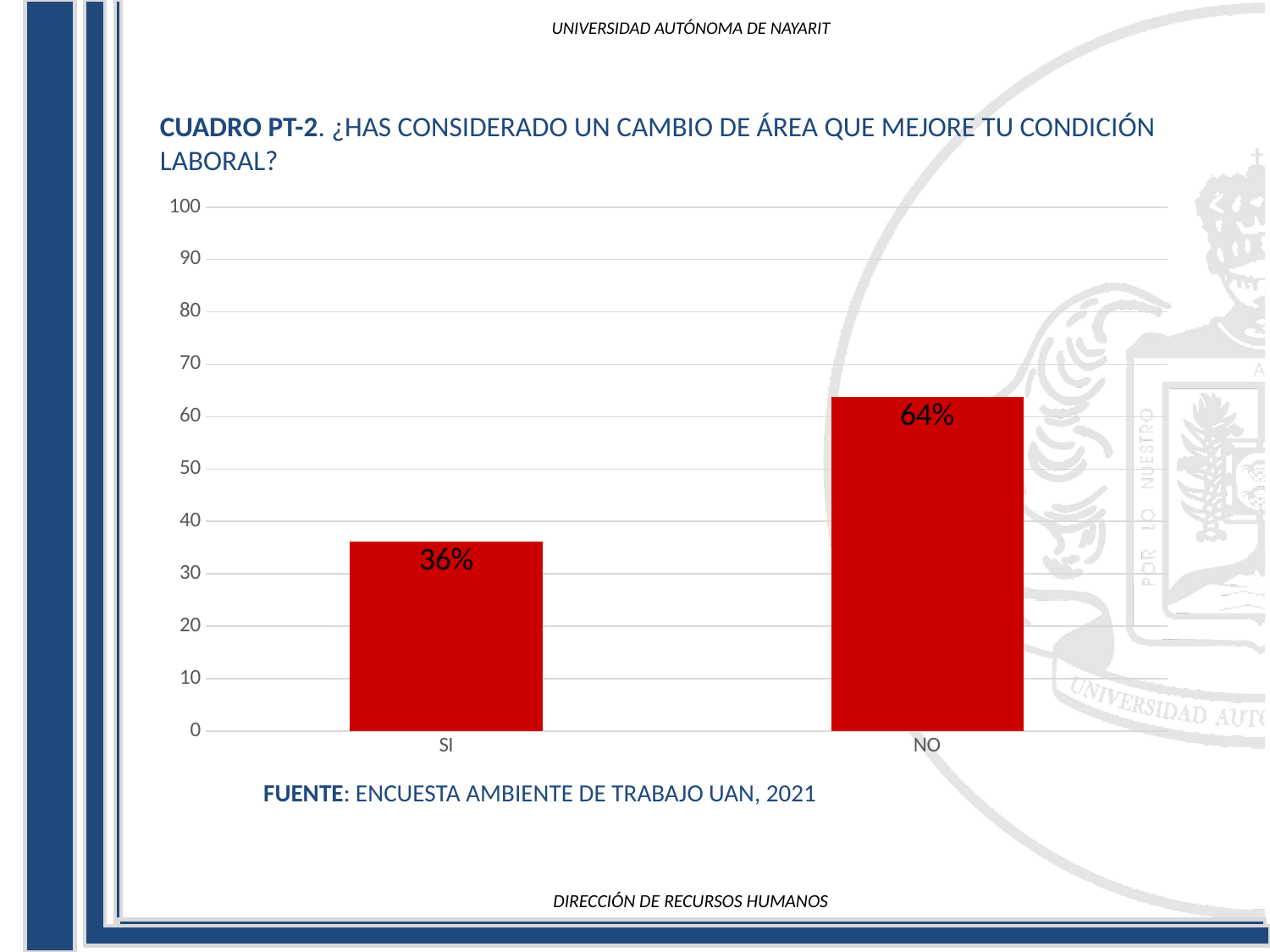
Is the value for NO greater or less than 60? greater Which category has the lowest value? SI What is the difference between the values for NO and SI? 28% What is the value for SI? 36% What kind of chart is shown on the slide? bar chart Is the value for SI greater or less than 40? less What colour are the bars in the chart? red Which category has the highest value? NO What is the source cited below the chart? ENCUESTA AMBIENTE DE TRABAJO UAN, 2021 What is the value for NO? 64% How many categories are shown on the x axis? 2 Which is larger, the value for SI or the value for NO? NO